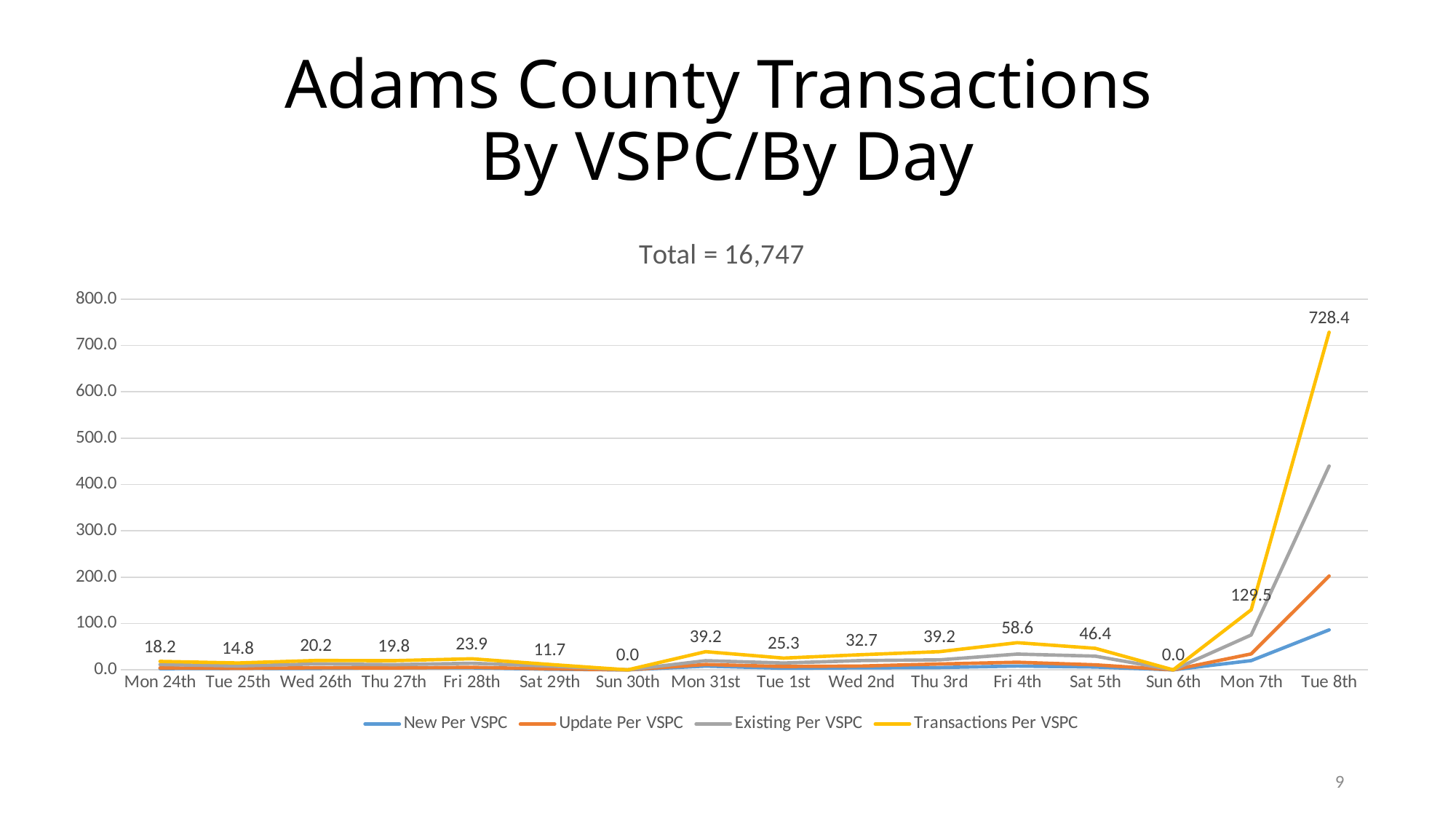
Is the Existing Per VSPC value on Tue 8th greater or less than 400.0? greater How many days are plotted along the x axis? 16 What is the difference in Transactions Per VSPC between Tue 8th and Mon 7th? 598.9 What is the Transactions Per VSPC value on Tue 8th? 728.4 What total is stated in the chart title? Total = 16,747 How many series does the legend list? 4 What is the Transactions Per VSPC value on Mon 7th? 129.5 What type of chart is shown on the slide? line chart On which day is Transactions Per VSPC highest? Tue 8th Is the New Per VSPC value on Tue 8th greater or less than 100.0? less What is the Transactions Per VSPC value on Fri 4th? 58.6 Which is larger, Transactions Per VSPC on Fri 4th or on Sat 5th? Fri 4th